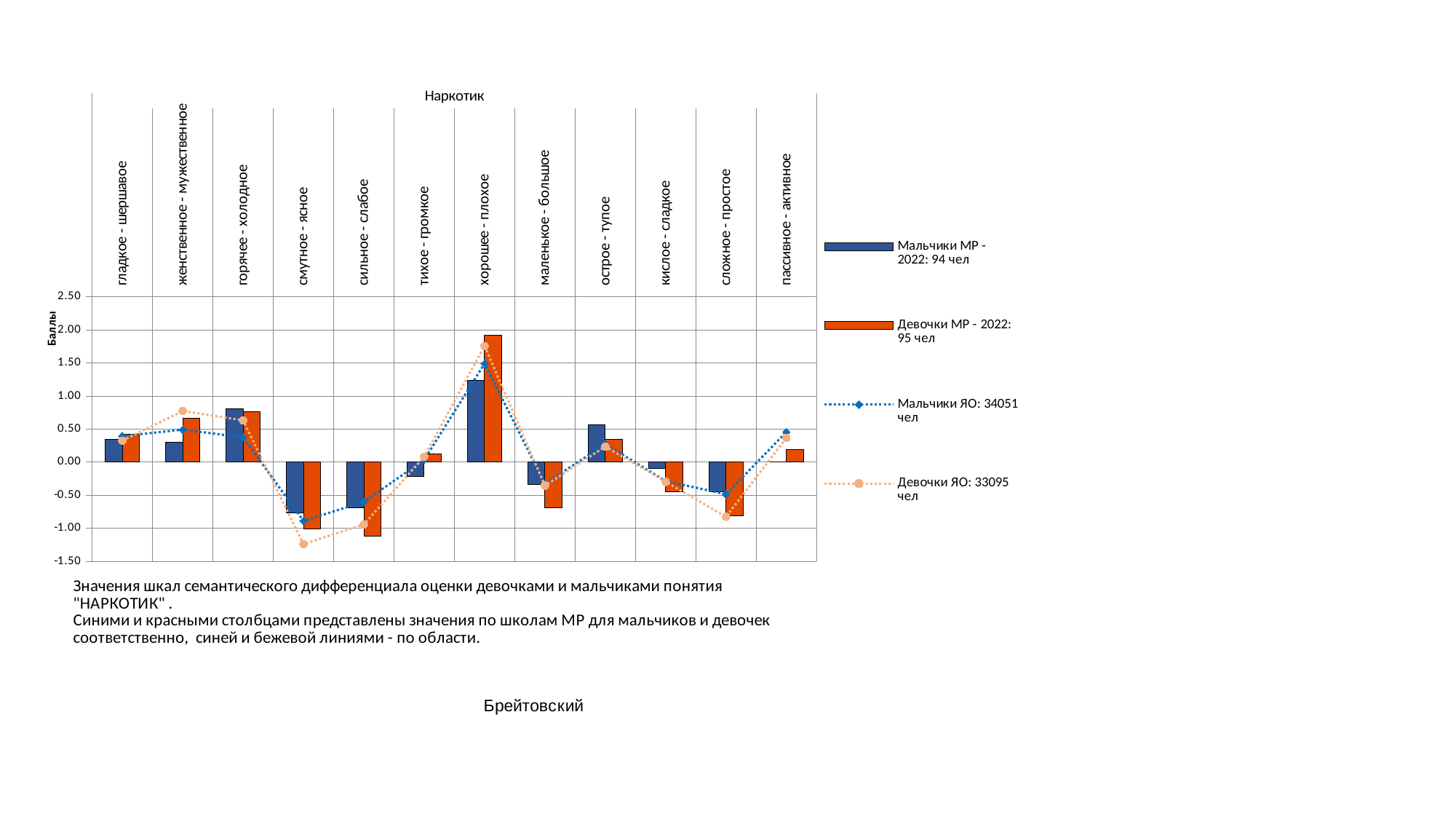
At 'острое - тупое', which bar is higher: 'Мальчики МР - 2022: 94 чел' or 'Девочки МР - 2022: 95 чел'? Мальчики МР - 2022: 94 чел For which category is the bar for 'Девочки МР - 2022: 95 чел' the lowest? сильное - слабое How many categories are shown along the x axis of the chart? 12 How many series does the chart legend list? 4 For which category is the bar for 'Мальчики МР - 2022: 94 чел' the highest? хорошее - плохое For which category is the bar for 'Девочки МР - 2022: 95 чел' the highest? хорошее - плохое Is the value for 'Девочки МР - 2022: 95 чел' at 'хорошее - плохое' greater or less than 1.50? greater Is the value for 'Девочки ЯО: 33095 чел' at 'смутное - ясное' greater or less than -1.00? less What is the title of the chart? Наркотик What is the label of the vertical axis? Баллы What kind of chart is shown on the slide? Combined bar and line chart At 'маленькое - большое', which bar is lower: 'Мальчики МР - 2022: 94 чел' or 'Девочки МР - 2022: 95 чел'? Девочки МР - 2022: 95 чел